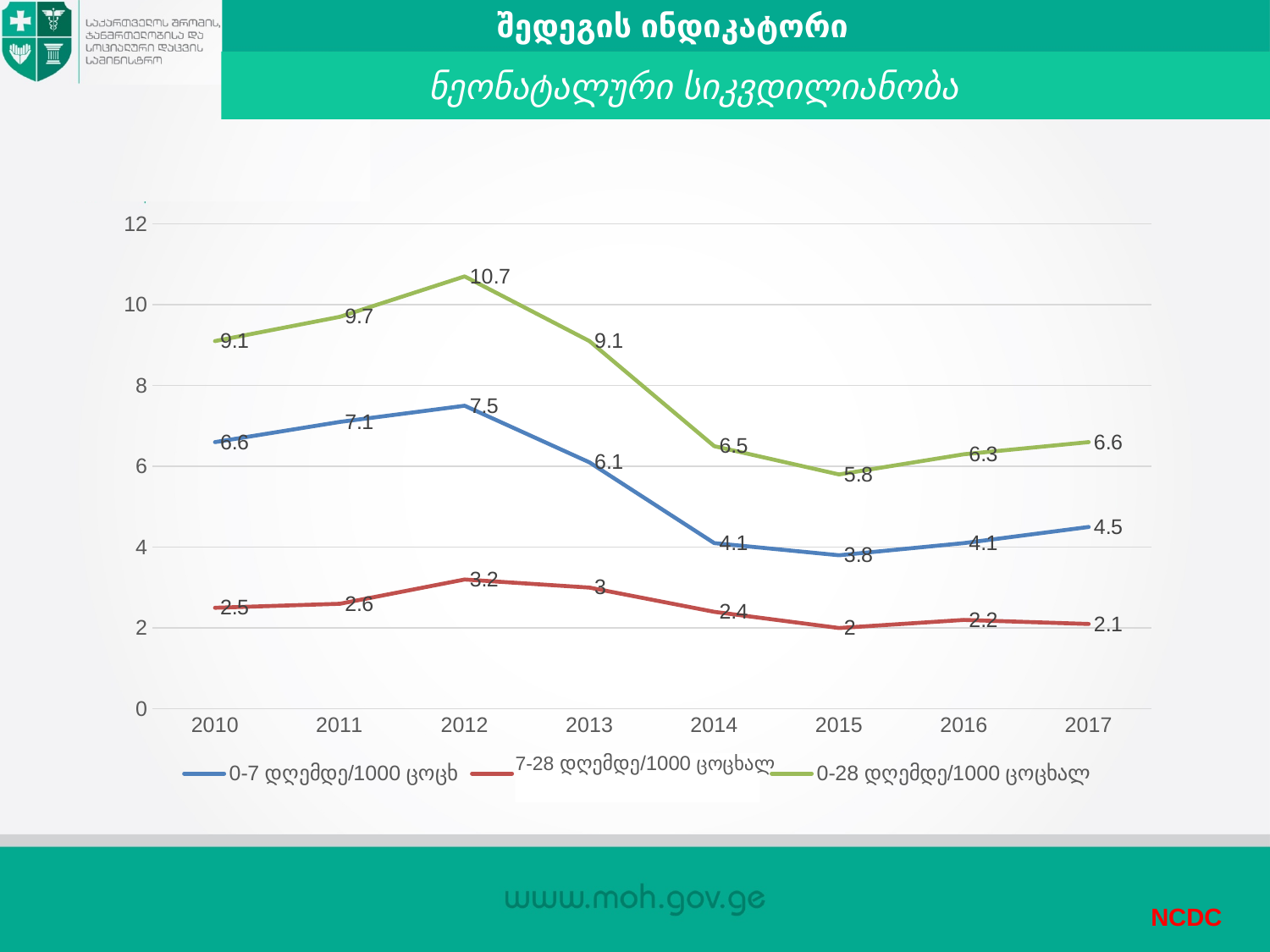
What is the value of the red line (7-28 დღემდე/1000 ცოცხალ) in 2017? 2.1 What is the difference between the green line's value in 2012 and its value in 2015? 4.9 How many years are shown on the x axis? 8 In which year does the green line (0-28 დღემდე/1000 ცოცხალ) reach its highest value? 2012 Which series is drawn in green in the legend? 0-28 დღემდე/1000 ცოცხალ Does the green line (0-28 დღემდე/1000 ცოცხალ) rise or fall between 2012 and 2015? fall Which is larger: the blue line's value in 2010 or its value in 2017? 2010 In which year does the red line (7-28 დღემდე/1000 ცოცხალ) reach its lowest value? 2015 What type of chart is shown on the slide? line chart What is the value of the green line (0-28 დღემდე/1000 ცოცხალ) in 2012? 10.7 How many series does the legend list? 3 What is the value of the blue line (0-7 დღემდე/1000 ცოცხ) in 2015? 3.8